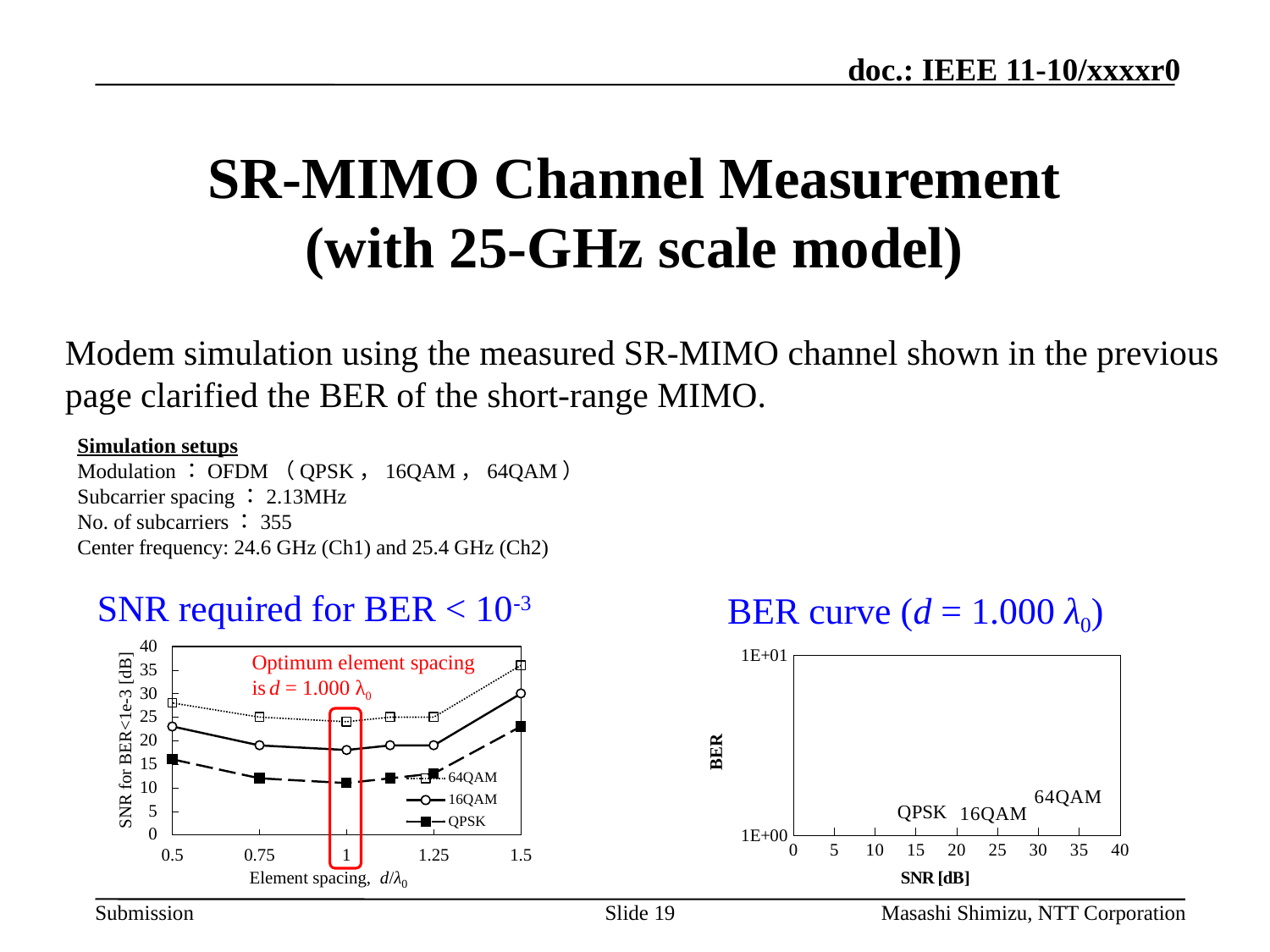
In the 'SNR required for BER < 10^-3' chart, which series has the highest SNR values across all element spacings? 64QAM What kind of chart is the 'SNR required for BER < 10^-3' chart? line chart What is the x-axis title of the 'BER curve (d = 1.000 λ0)' chart? SNR [dB] In the 'SNR required for BER < 10^-3' chart, at element spacing 1, which is larger: the 64QAM value or the QPSK value? 64QAM In the 'SNR required for BER < 10^-3' chart, is the 64QAM value at element spacing 0.5 greater or less than 25? greater In the 'SNR required for BER < 10^-3' chart, is the 64QAM value at element spacing 1.5 greater or less than 30? greater In the 'SNR required for BER < 10^-3' chart, is the 16QAM value at element spacing 1.5 greater or less than 25? greater How many series does the legend of the 'SNR required for BER < 10^-3' chart list? 3 What is the x-axis title of the 'SNR required for BER < 10^-3' chart? Element spacing, d/λ0 In the 'SNR required for BER < 10^-3' chart, which series has the lowest SNR values across all element spacings? QPSK In the 'SNR required for BER < 10^-3' chart, do the 16QAM values rise or fall as element spacing goes from 1 to 1.5? rise